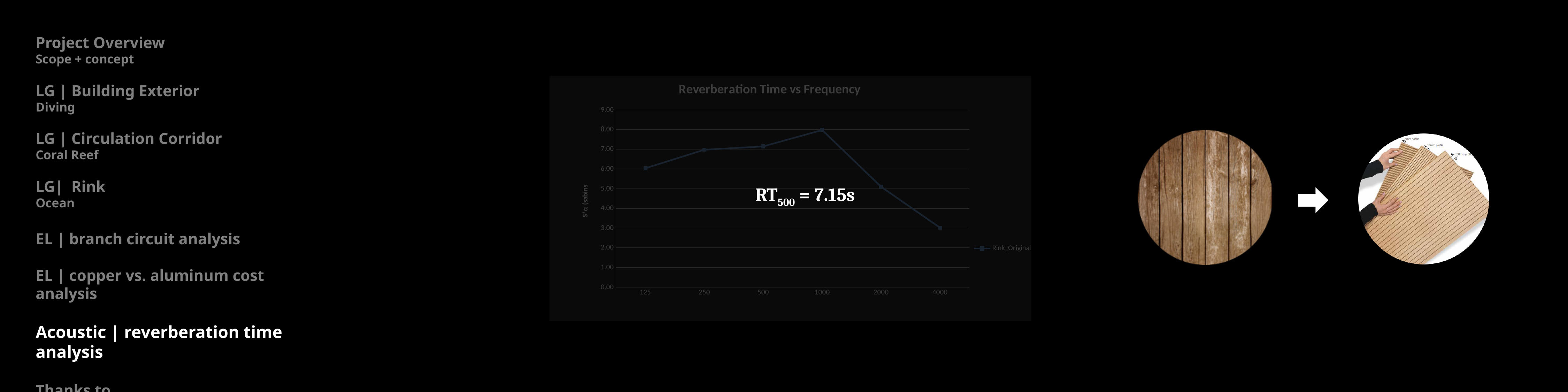
At which frequency is the plotted value lowest? 4000 Is the value at 250 greater or less than 6.00? greater What kind of chart is shown on the slide? line chart At which frequency is the plotted value highest? 1000 How many frequency points are plotted along the x axis? 6 What series name does the chart legend list? Rink_Original How many series does the legend list? 1 Which has the larger value, 250 or 2000? 250 What is the title of the chart? Reverberation Time vs Frequency Does the line rise or fall between 1000 and 4000? fall What is the reverberation time at 500 Hz, as stated on the slide? 7.15s Is the value at 2000 greater or less than 6.00? less